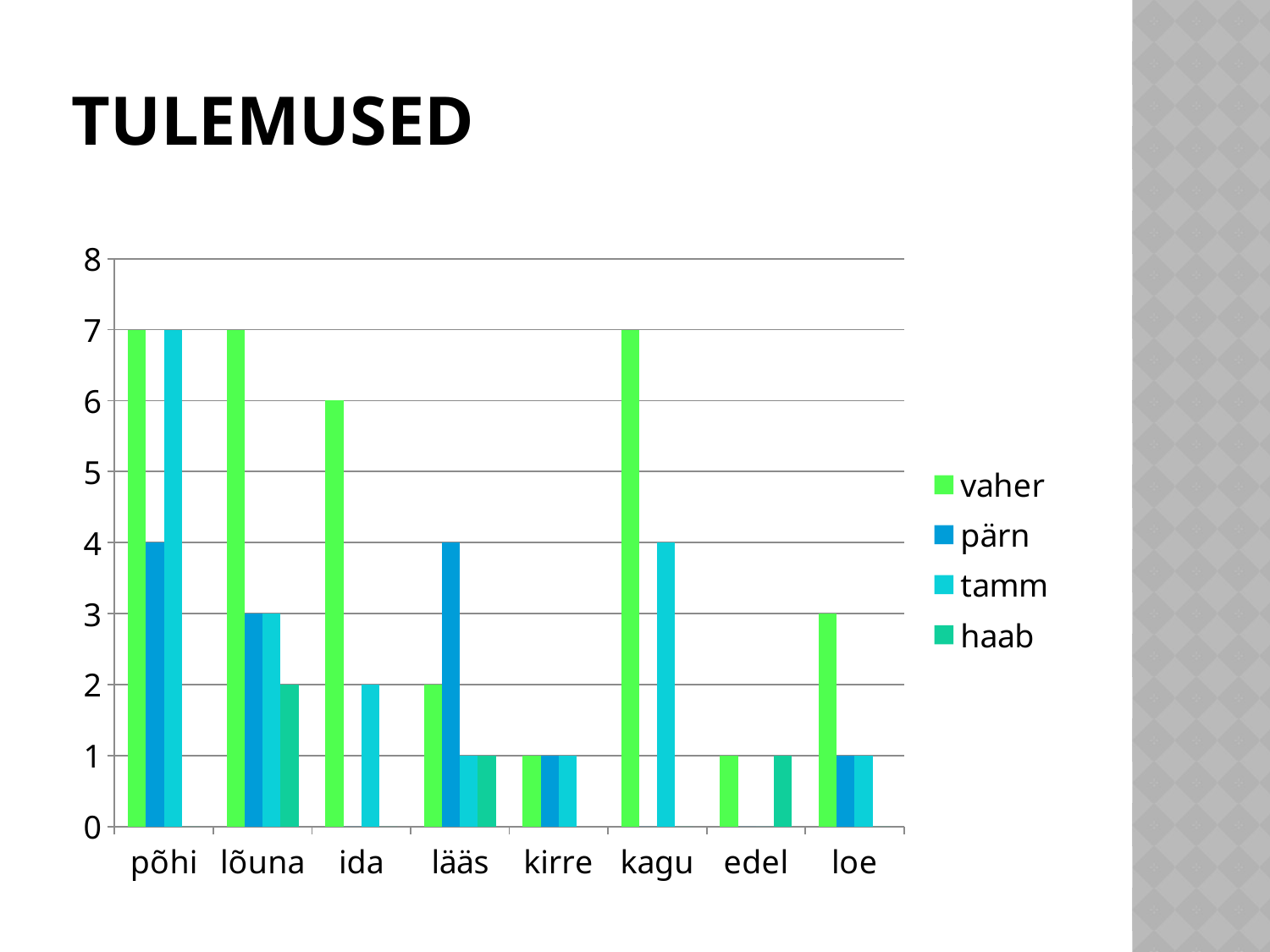
How many series does the legend list? 4 What is the value for pärn in the põhi category? 4 How many categories are shown on the x axis? 8 Which is larger in the lääs category, vaher or pärn? pärn What is the title of the slide? TULEMUSED What type of chart is shown on the slide? bar chart What is the value for tamm in the kagu category? 4 What is the value for vaher in the ida category? 6 What is the difference between the vaher value and the pärn value in the lõuna category? 4 What is the value for haab in the lõuna category? 2 Is the value for vaher in the kagu category greater or less than 5? greater In which category is the pärn value highest? põhi and lääs